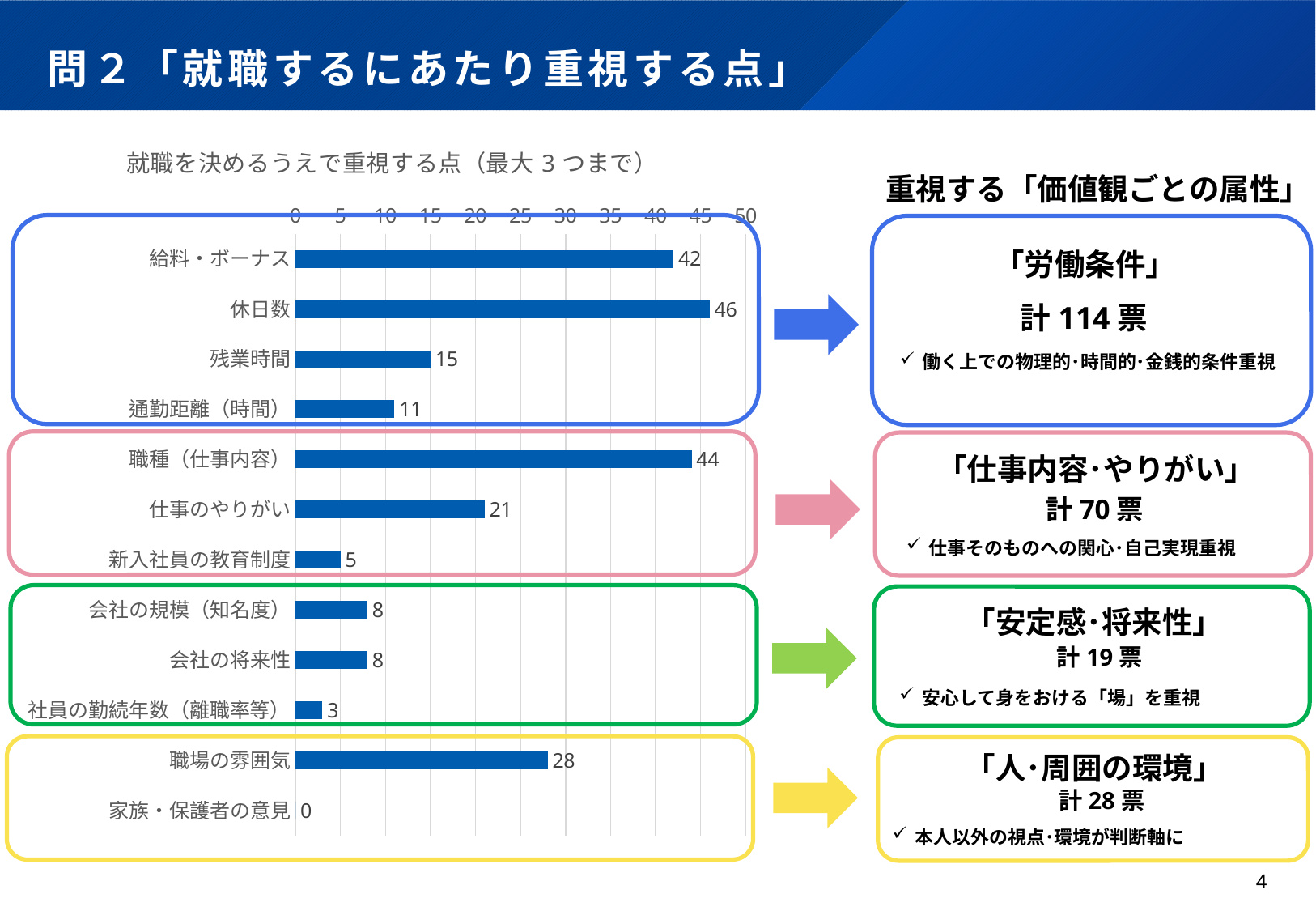
What is the value for 新入社員の教育制度? 5 Which category has the highest value? 休日数 What is the difference between the values for 休日数 and 給料・ボーナス? 4 Which is larger, the value for 職種（仕事内容） or the value for 給料・ボーナス? 職種（仕事内容） What is the value for 職場の雰囲気? 28 What is the value for 休日数? 46 Is the value for 残業時間 greater or less than 20? less What is the difference between the values for 職種（仕事内容） and 仕事のやりがい? 23 What is the title of the chart? 就職を決めるうえで重視する点（最大3つまで） Which category has the lowest value? 家族・保護者の意見 How many categories are shown in the chart? 12 What kind of chart is shown on the slide? bar chart